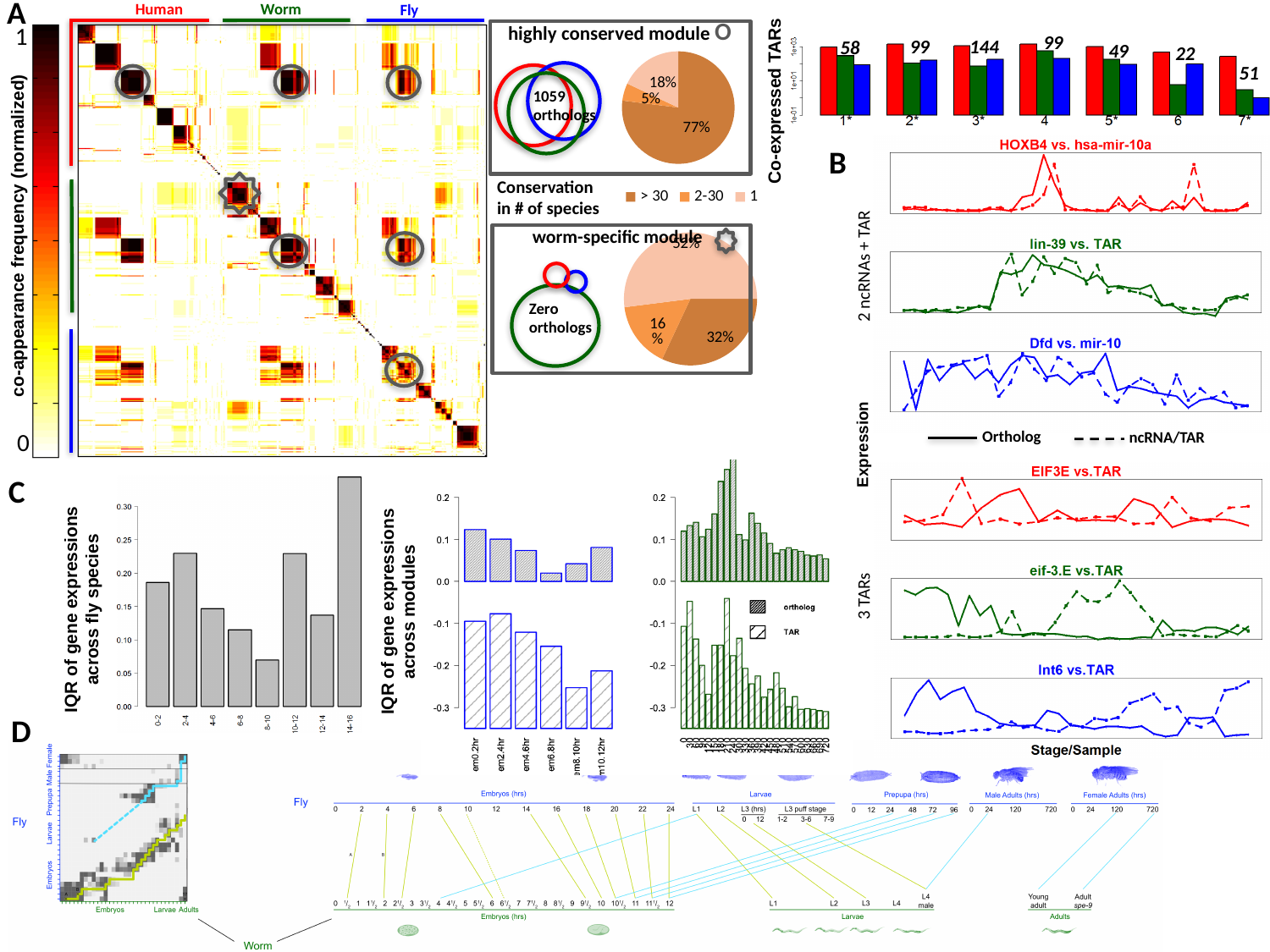
How many categories are on the x axis of the 'IQR of gene expressions across fly species' bar chart? 8 In the 'Co-expressed TARs' bar chart, what is the difference between the numbers printed above groups 1* and 6? 36 How many categories does the 'Conservation in # of species' legend list? 3 In the 'Co-expressed TARs' bar chart, what number is printed above group 3*? 144 In the 'highly conserved module' pie chart, what is the smallest percentage shown? 5% In panel B, what does the solid line represent according to the legend? Ortholog In the 'IQR of gene expressions across fly species' bar chart, which category has the shortest bar? 8-10 In the 'highly conserved module' pie chart, what percentage is shown for the largest slice? 77% In the 'IQR of gene expressions across fly species' bar chart, which category has the tallest bar? 14-16 In the 'highly conserved module' pie chart, what is the difference between the 77% slice and the 18% slice? 59% In the 'IQR of gene expressions across fly species' bar chart, is the value for 14-16 greater or less than 0.30? greater In the 'Co-expressed TARs' bar chart, which group has the smallest printed number? 6